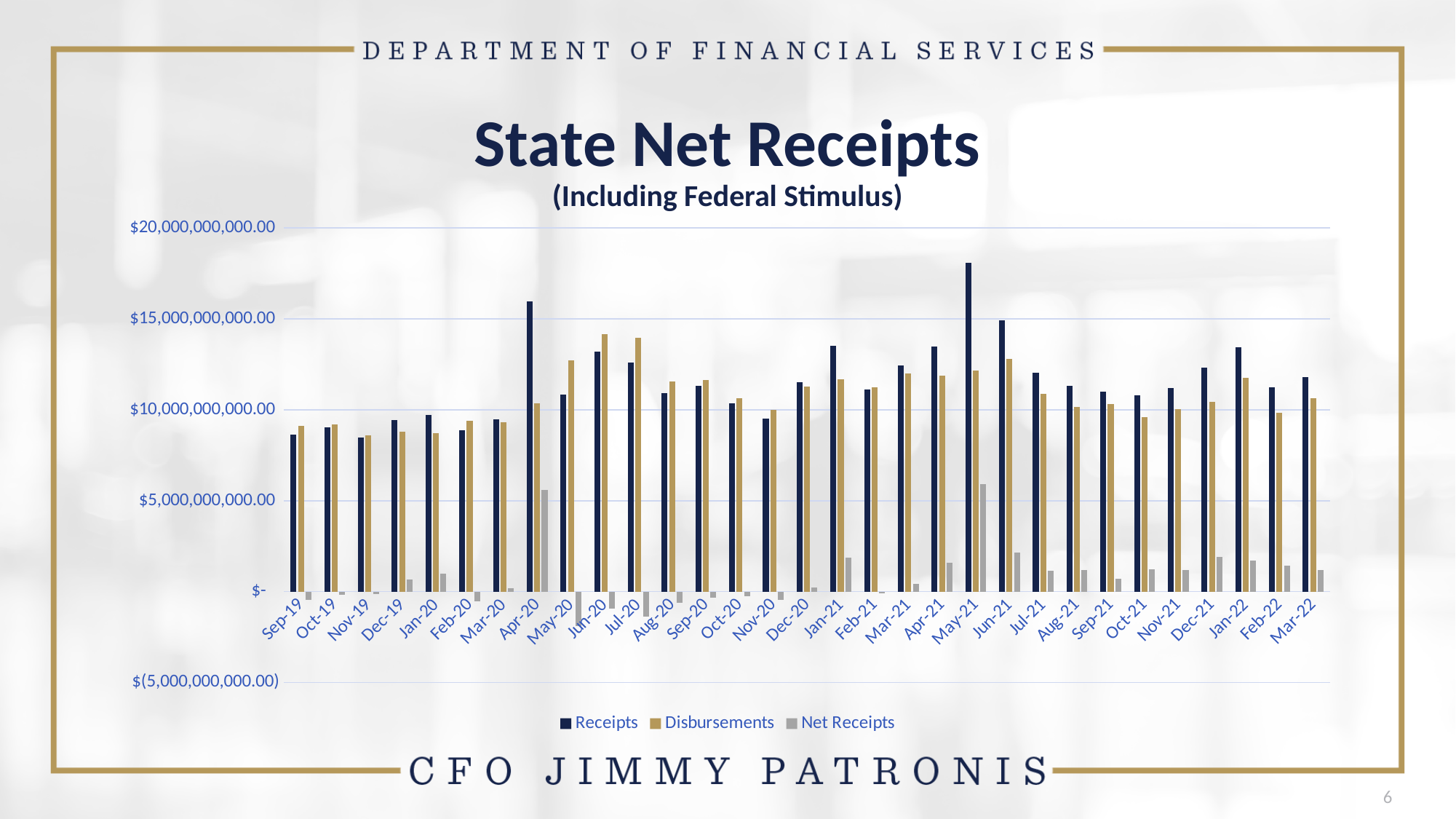
Is the Net Receipts value for Jan-21 greater or less than $5,000,000,000.00? less What is the subtitle shown under the chart title 'State Net Receipts'? (Including Federal Stimulus) Which month has the highest Receipts value? May-21 How many months are shown along the x axis? 31 How many series does the legend list? 3 In Jun-20, which is larger, Receipts or Disbursements? Disbursements Is the Receipts value for Apr-20 greater or less than $15,000,000,000.00? greater What kind of chart is shown on the slide? bar chart Is the Disbursements value for Jun-20 greater or less than $10,000,000,000.00? greater In Apr-20, which is larger, Receipts or Disbursements? Receipts